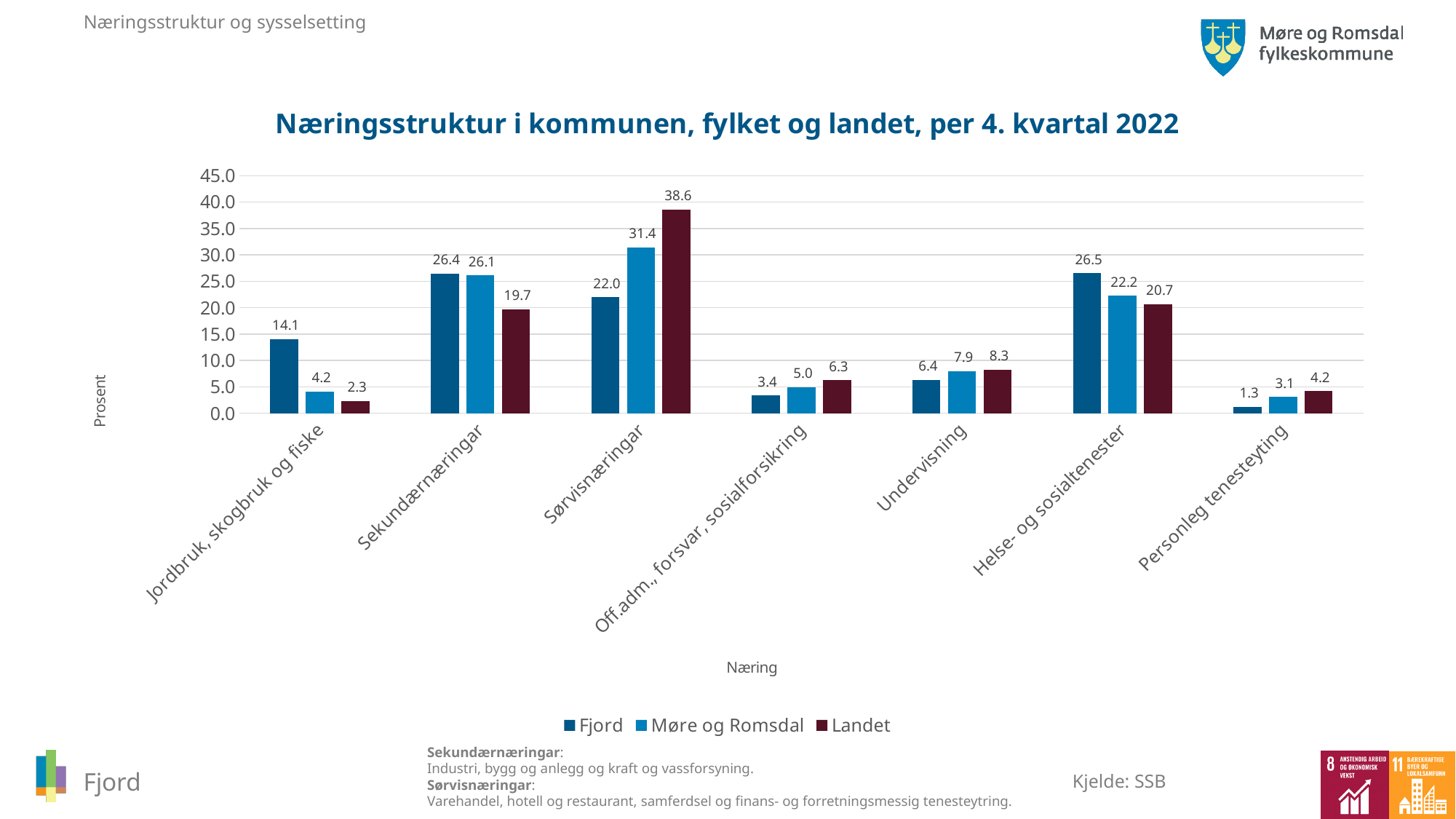
What is the value for Møre og Romsdal in the Helse- og sosialtenester category? 22.2 What kind of chart is shown on the slide? Bar chart Which category has the highest value for Landet? Sørvisnæringar What is the value for Landet in the Sørvisnæringar category? 38.6 How many categories are shown on the x axis? 7 What is the title of the chart? Næringsstruktur i kommunen, fylket og landet, per 4. kvartal 2022 Which is larger in the Undervisning category: the value for Fjord or the value for Landet? Landet Which category has the lowest value for Fjord? Personleg tenesteyting How many series does the legend list? 3 What is the difference between the Fjord and Landet values in the Jordbruk, skogbruk og fiske category? 11.8 What is the value for Fjord in the Jordbruk, skogbruk og fiske category? 14.1 Is the value for Møre og Romsdal in the Sørvisnæringar category greater or less than 30.0? greater